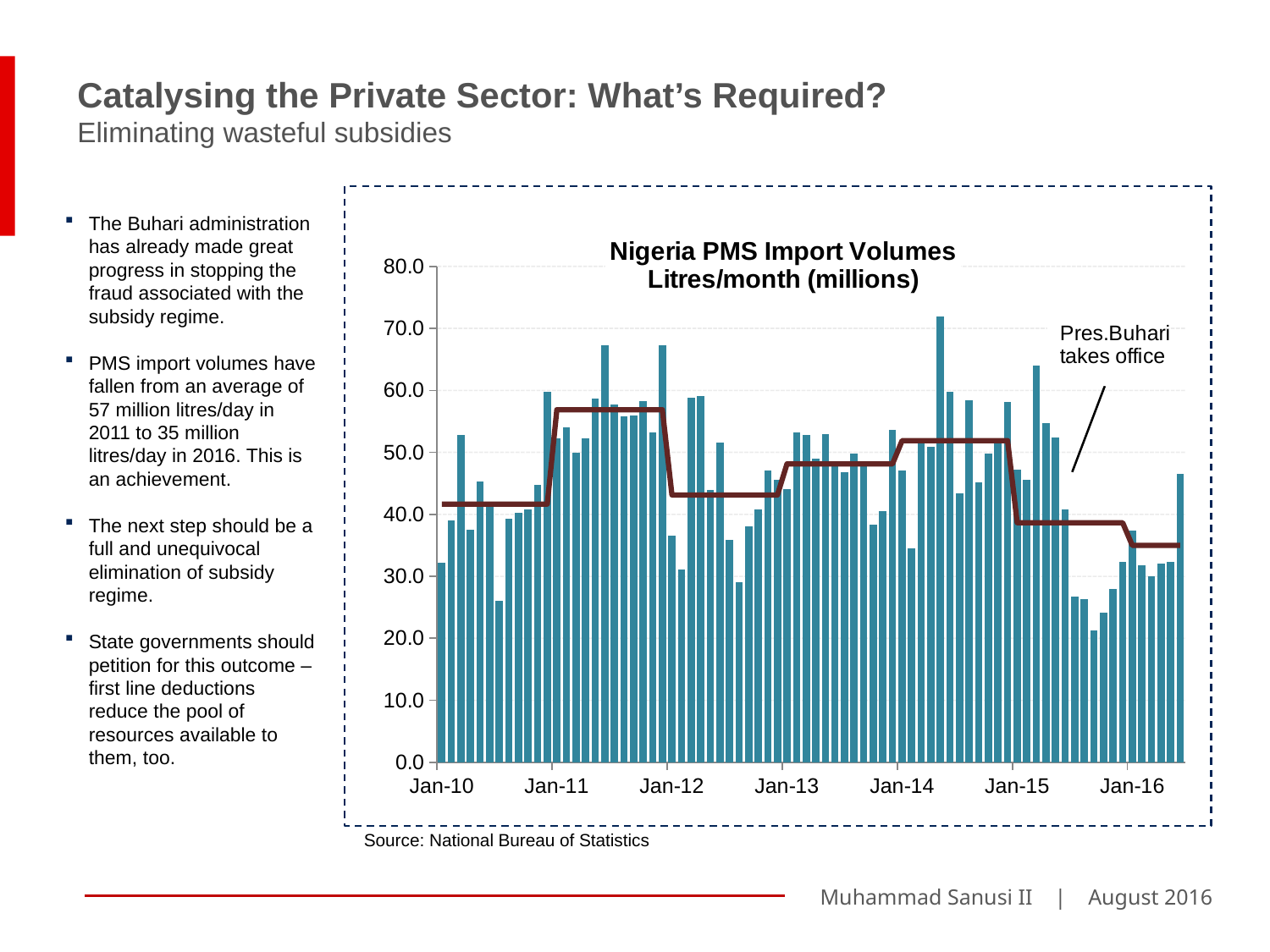
Is the bar at Jan-10 greater or less than 40? less Is the level of the dark step line during 2016 greater or less than 40? less How many year labels are shown along the x axis of the chart? 7 Does the dark step line rise or fall between 2014 and 2016? Fall Is the bar at Jan-12 greater or less than 60? less What is the highest value shown on the vertical axis of the chart? 80.0 What event does the annotation on the chart mark? Pres.Buhari takes office What kind of chart is shown on the slide? Bar chart What is the title of the chart? Nigeria PMS Import Volumes Litres/month (millions)